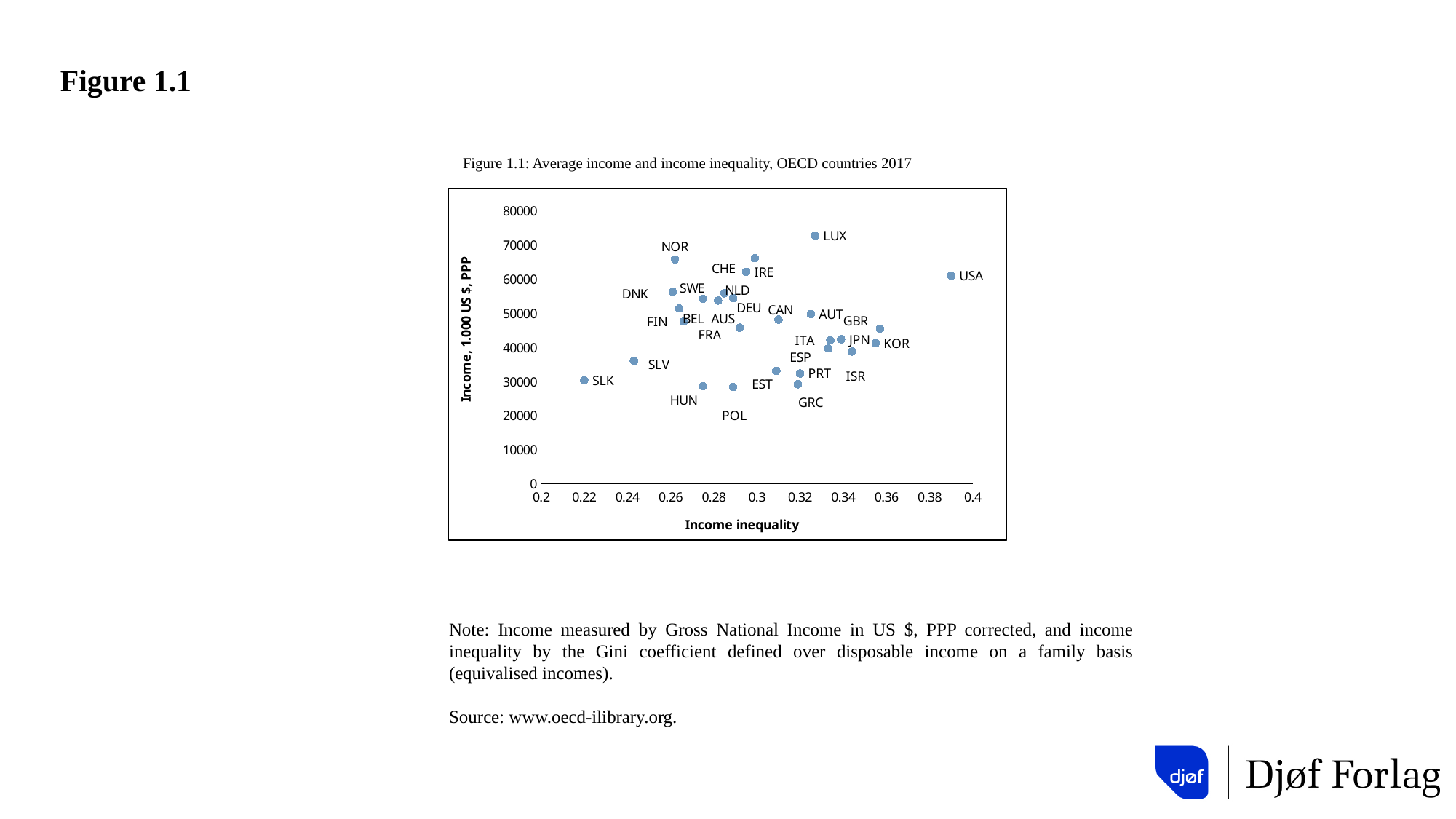
Is the income value for SLV greater or less than 40000? less Is the income value for NOR greater or less than 60000? greater Which has the higher income, NOR or DNK? NOR What kind of chart is shown on the slide? Scatter chart Which has the higher income inequality, USA or KOR? USA What is the label of the vertical axis? Income, 1.000 US $, PPP Is the income inequality value for USA greater or less than 0.38? greater Which country has the lowest income inequality in the chart? SLK Which country has the highest income inequality in the chart? USA What is the title of the chart? Figure 1.1: Average income and income inequality, OECD countries 2017 Which country has the highest income in the chart? LUX